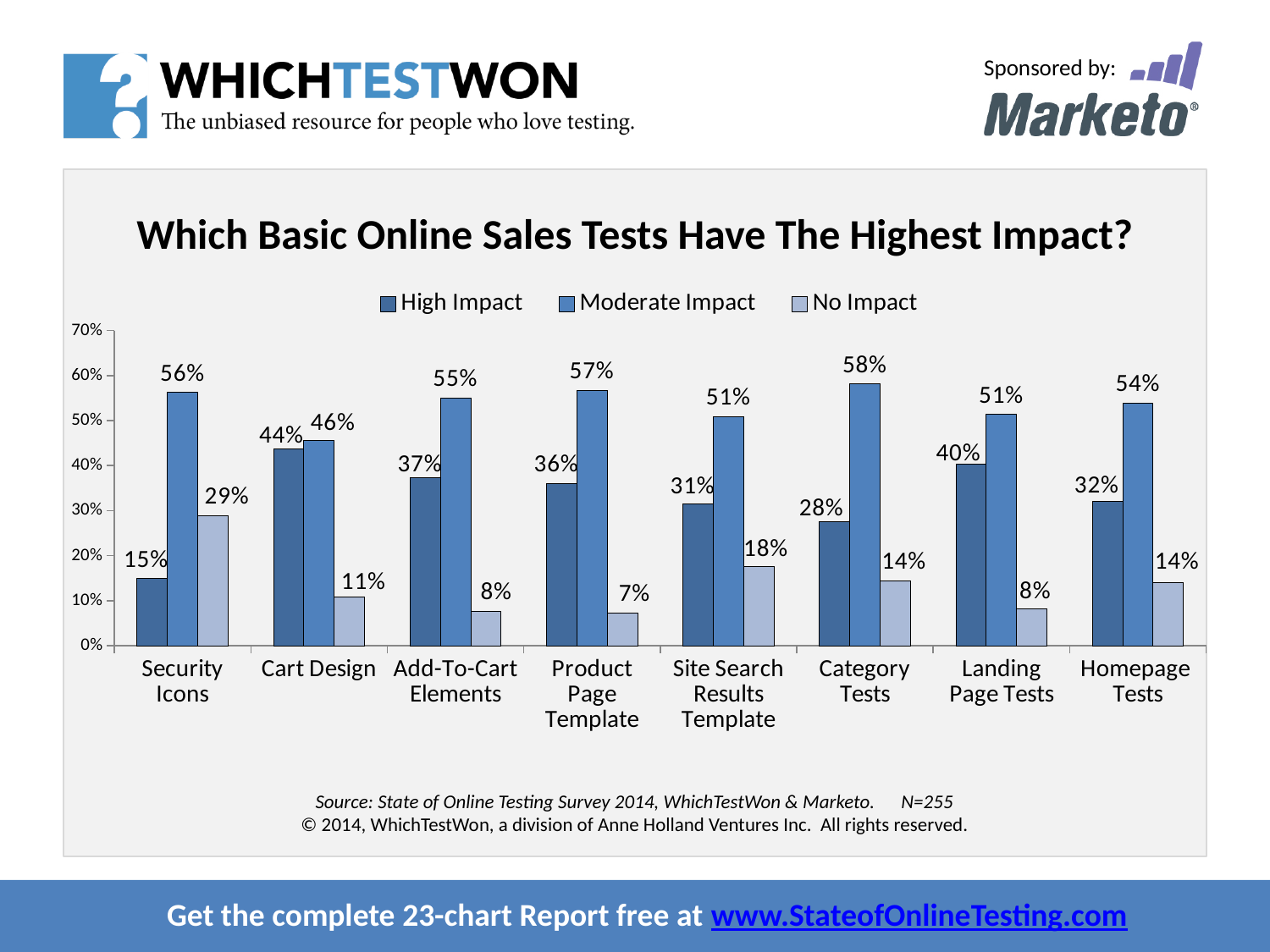
What is the Moderate Impact value for Category Tests? 58% What is the difference between the Moderate Impact and High Impact values for Security Icons? 41% Which category has the highest High Impact value? Cart Design How many categories are shown on the x axis? 8 What kind of chart is shown? Bar chart What is the title of the chart? Which Basic Online Sales Tests Have The Highest Impact? How many series does the legend list? 3 Which category has the lowest High Impact value? Security Icons Which category has the lowest No Impact value? Product Page Template What is the High Impact value for Cart Design? 44% What is the No Impact value for Security Icons? 29% Which is larger: the High Impact value for Landing Page Tests or the High Impact value for Homepage Tests? Landing Page Tests